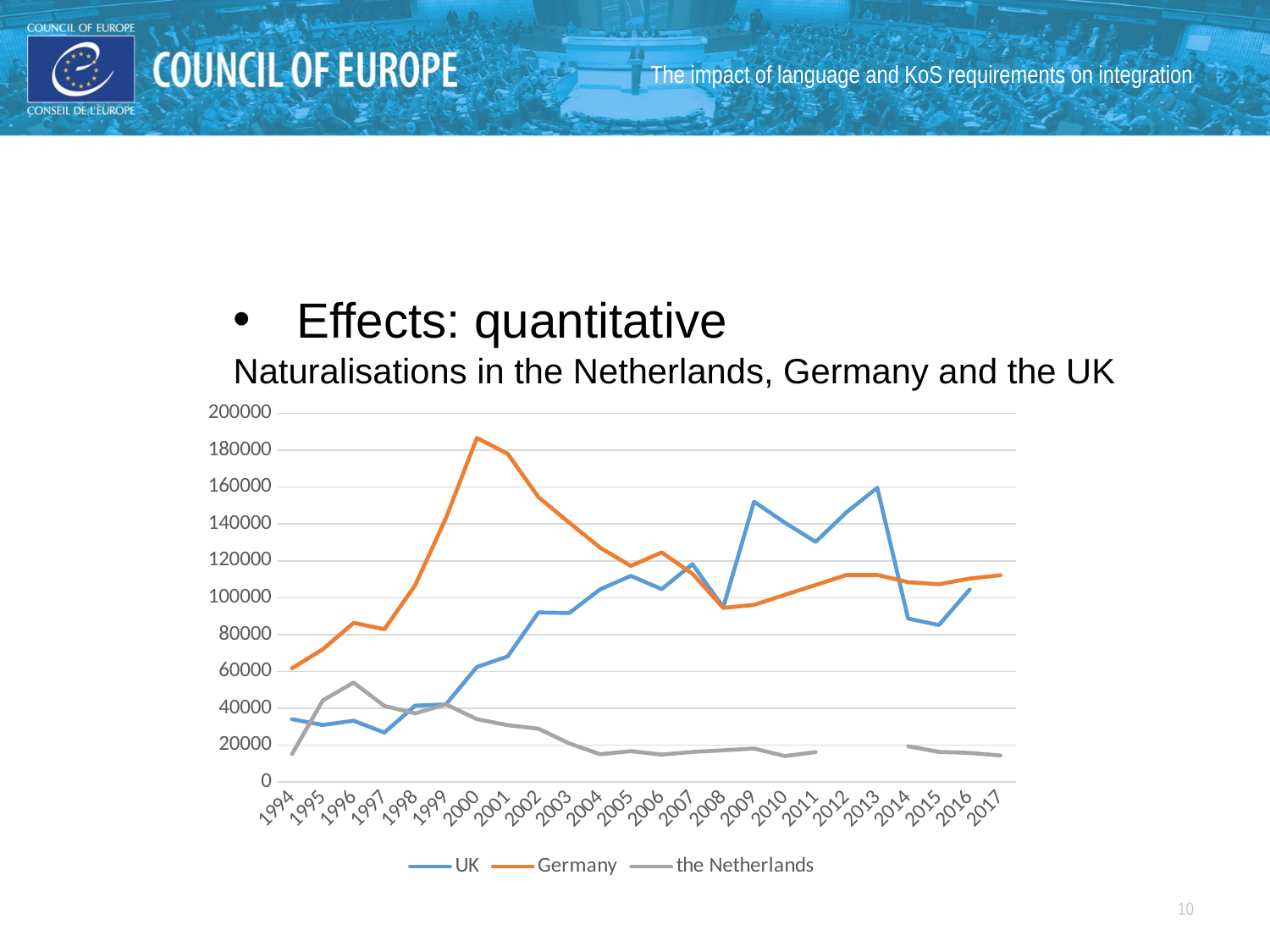
How many series does the legend list? 3 Does the Netherlands series rise or fall between 1996 and 2004? fall In which year does the UK series reach its highest value? 2013 Is the value for Germany in 2000 greater or less than 180000? greater Is the value for the Netherlands in 2017 greater or less than 20000? less What kind of chart is shown on the slide? line chart In which year does the Germany series reach its highest value? 2000 What is the title of the chart? Naturalisations in the Netherlands, Germany and the UK In which year does the Netherlands series reach its highest value? 1996 In 2009, which series has the larger value, UK or Germany? UK How many years are shown along the x axis? 24 Is the value for the UK in 2015 greater or less than 100000? less